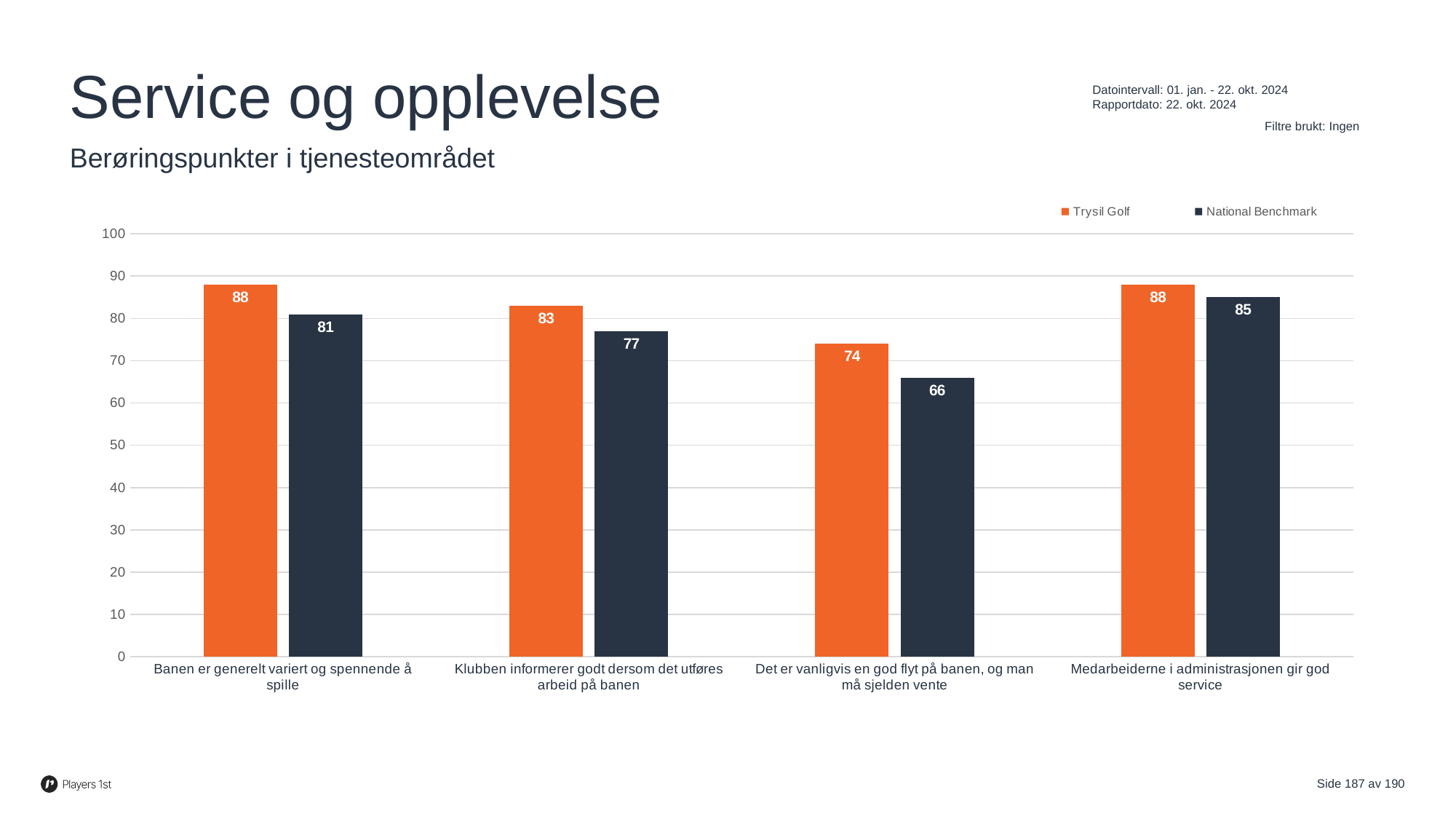
For "Medarbeiderne i administrasjonen gir god service", which is larger: Trysil Golf or National Benchmark? Trysil Golf Is the National Benchmark value for "Banen er generelt variert og spennende å spille" greater or less than 70? greater What is the National Benchmark value for "Det er vanligvis en god flyt på banen, og man må sjelden vente"? 66 What is the Trysil Golf value for "Banen er generelt variert og spennende å spille"? 88 Which category has the lowest Trysil Golf value? Det er vanligvis en god flyt på banen, og man må sjelden vente What is the National Benchmark value for "Medarbeiderne i administrasjonen gir god service"? 85 How many categories are shown on the x axis? 4 How many series does the legend list? 2 What kind of chart is shown on the slide? Bar chart Which category has the highest National Benchmark value? Medarbeiderne i administrasjonen gir god service What is the difference between the Trysil Golf and National Benchmark values for "Det er vanligvis en god flyt på banen, og man må sjelden vente"? 8 What is the difference between the Trysil Golf and National Benchmark values for "Klubben informerer godt dersom det utføres arbeid på banen"? 6